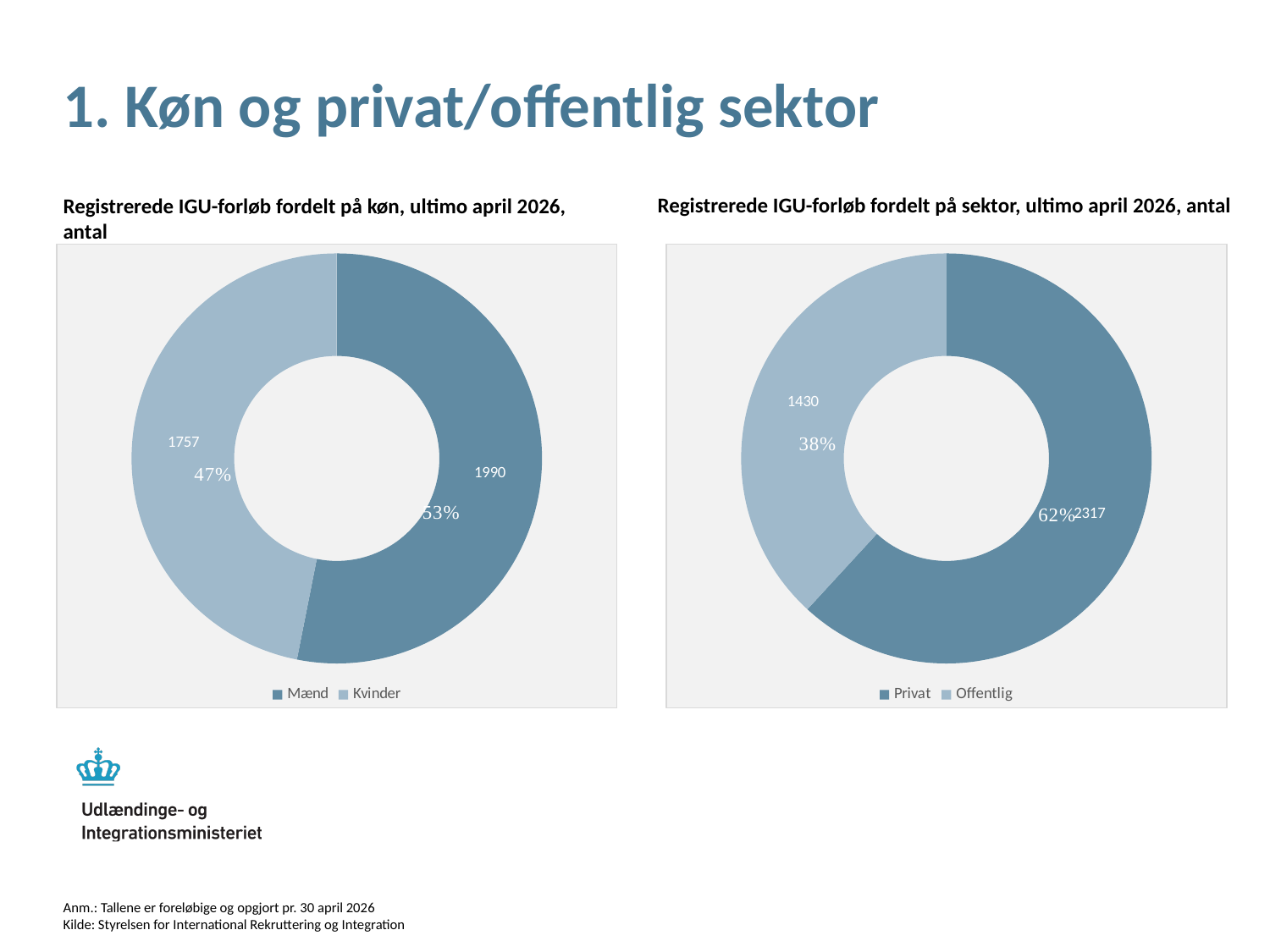
In the chart 'Registrerede IGU-forløb fordelt på køn, ultimo april 2026, antal', what is the difference between Mænd and Kvinder? 233 In the chart 'Registrerede IGU-forløb fordelt på køn, ultimo april 2026, antal', what is the value for Mænd? 1990 In the chart 'Registrerede IGU-forløb fordelt på køn, ultimo april 2026, antal', what is the value for Kvinder? 1757 What kind of chart is the chart on the right of the slide? Doughnut chart In the chart 'Registrerede IGU-forløb fordelt på køn, ultimo april 2026, antal', which category is the largest? Mænd In the chart 'Registrerede IGU-forløb fordelt på sektor, ultimo april 2026, antal', what is the value for Offentlig? 1430 In the chart 'Registrerede IGU-forløb fordelt på sektor, ultimo april 2026, antal', what is the value for Privat? 2317 In the chart 'Registrerede IGU-forløb fordelt på sektor, ultimo april 2026, antal', which category is the smallest? Offentlig In the chart 'Registrerede IGU-forløb fordelt på sektor, ultimo april 2026, antal', what share of the total is Privat? 62% How many categories does the legend of the chart on the left of the slide list? 2 In the chart 'Registrerede IGU-forløb fordelt på sektor, ultimo april 2026, antal', what is the difference between Privat and Offentlig? 887 In the chart 'Registrerede IGU-forløb fordelt på køn, ultimo april 2026, antal', what share of the total is Kvinder? 47%